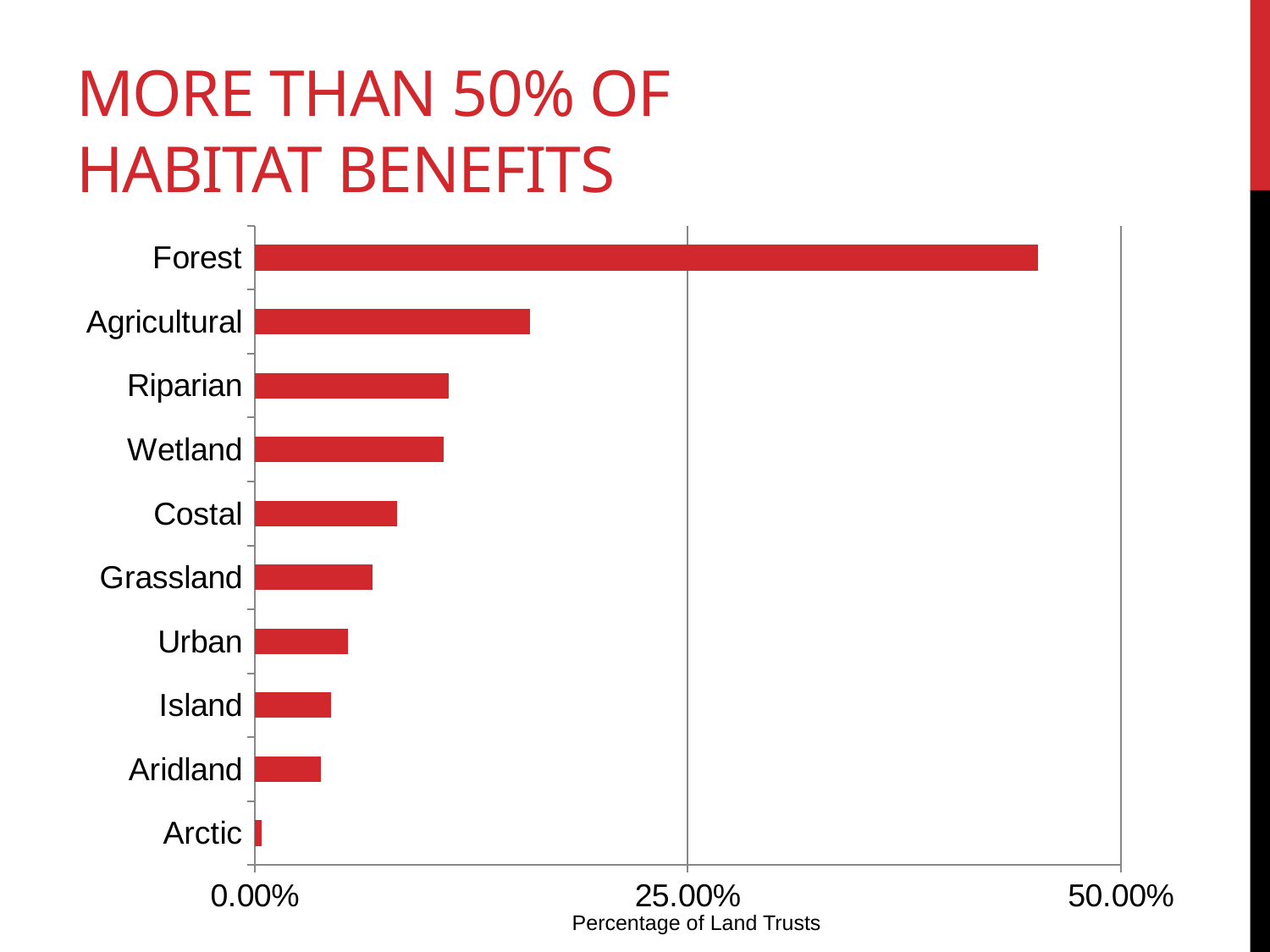
Which has a larger value, Forest or Agricultural? Forest Is the value for Agricultural greater or less than 25.00%? less Do the bar values increase or decrease going from the top category (Forest) to the bottom category (Arctic)? Decrease How many habitat categories are plotted in the chart? 10 Which habitat category has the highest percentage of land trusts? Forest What is the title of the slide containing the chart? MORE THAN 50% OF HABITAT BENEFITS What kind of chart is shown on the slide? Bar chart Which habitat category has the lowest percentage of land trusts? Arctic What is the label on the horizontal axis of the chart? Percentage of Land Trusts Which has a larger value, Costal or Arctic? Costal Is the value for Forest greater or less than 50.00%? less Is the value for Forest greater or less than 25.00%? greater